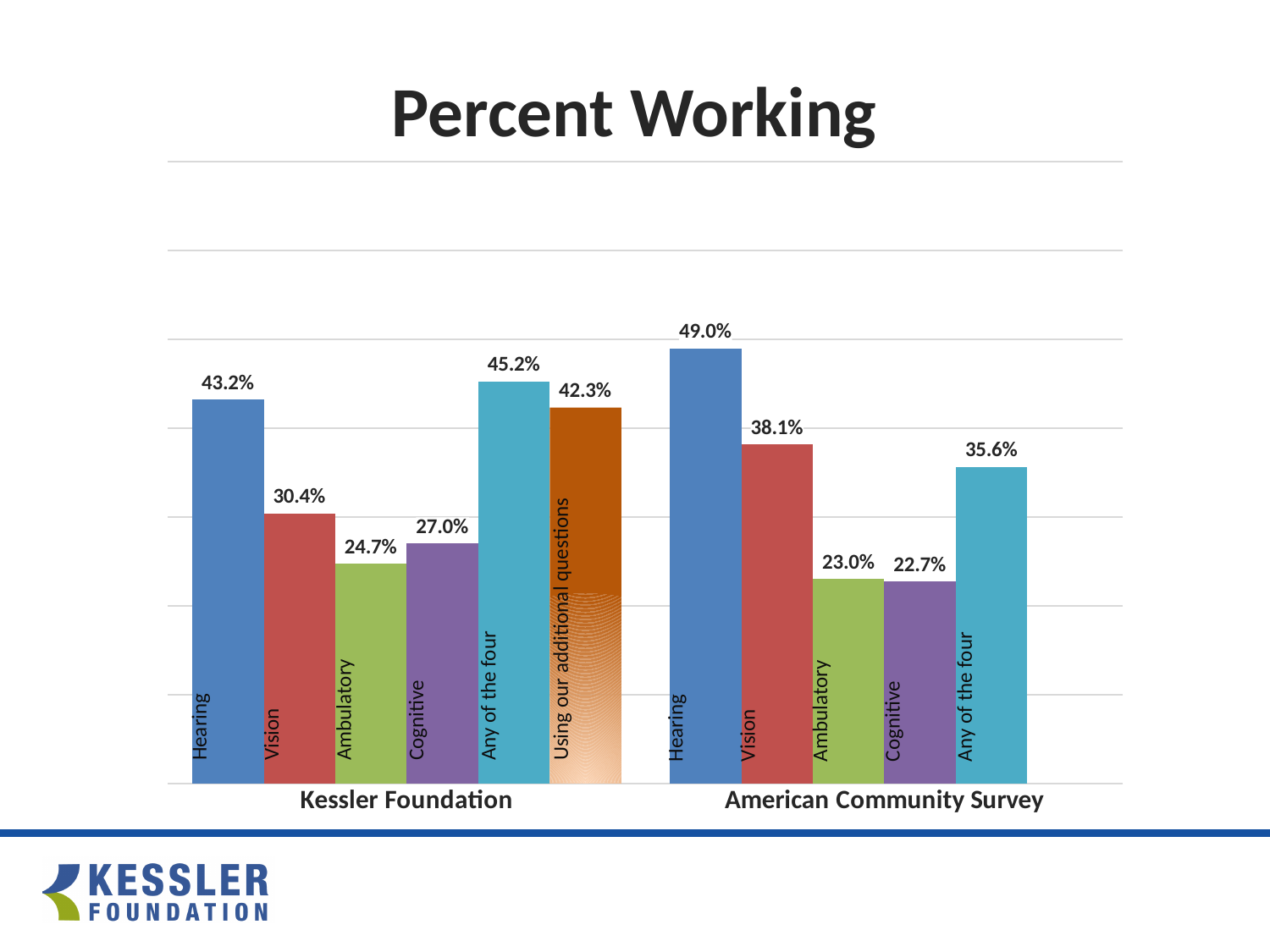
How many bars are shown in the Kessler Foundation group? 6 What is the difference between the Hearing values for the American Community Survey and the Kessler Foundation? 5.8% What is the percent working for Cognitive in the American Community Survey group? 22.7% What is the difference between 'Any of the four' and Cognitive in the Kessler Foundation group? 18.2% Which is larger: 'Any of the four' for the Kessler Foundation or 'Any of the four' for the American Community Survey? Kessler Foundation What is the title of the chart? Percent Working What kind of chart is shown on the slide? Bar chart Which category has the lowest percent working in the Kessler Foundation group? Ambulatory Which category has the highest percent working in the American Community Survey group? Hearing What is the percent working for Hearing in the Kessler Foundation group? 43.2% What is the percent working for Vision in the American Community Survey group? 38.1% What is the value for 'Using our additional questions' in the Kessler Foundation group? 42.3%